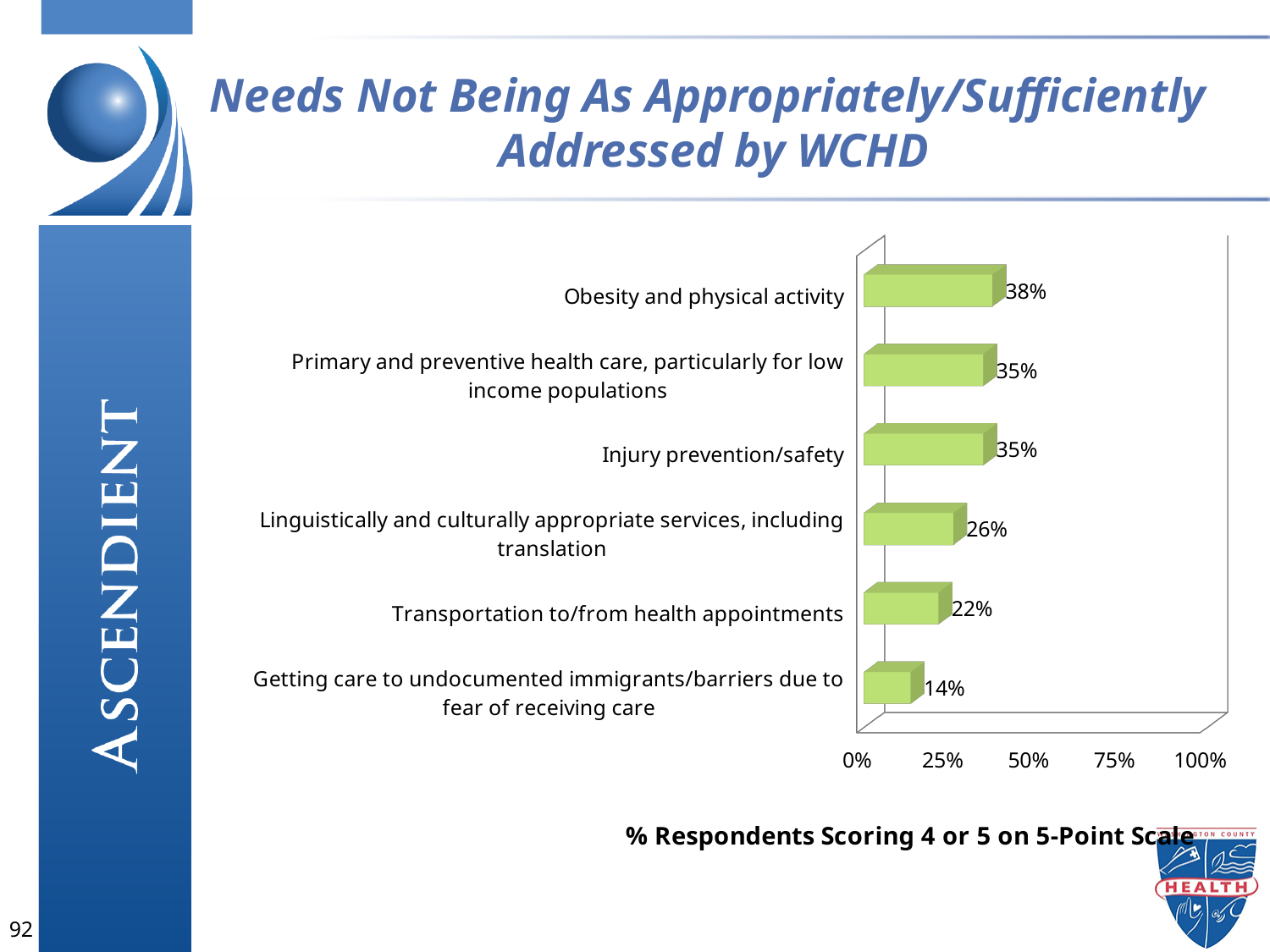
What is the difference between the values for Transportation to/from health appointments and Getting care to undocumented immigrants/barriers due to fear of receiving care? 8% Which is larger: the value for Injury prevention/safety or the value for Transportation to/from health appointments? Injury prevention/safety How many categories are shown in the chart? 6 Which category has the highest value? Obesity and physical activity What is the value for Linguistically and culturally appropriate services, including translation? 26% What is the title of the chart on the slide? Needs Not Being As Appropriately/Sufficiently Addressed by WCHD What kind of chart is shown on the slide? Bar chart What percentage of respondents scored 4 or 5 for Obesity and physical activity? 38% Which category has the lowest value? Getting care to undocumented immigrants/barriers due to fear of receiving care Is the value for Obesity and physical activity greater or less than 50%? less What is the difference between the values for Obesity and physical activity and Injury prevention/safety? 3% What is the value for Transportation to/from health appointments? 22%